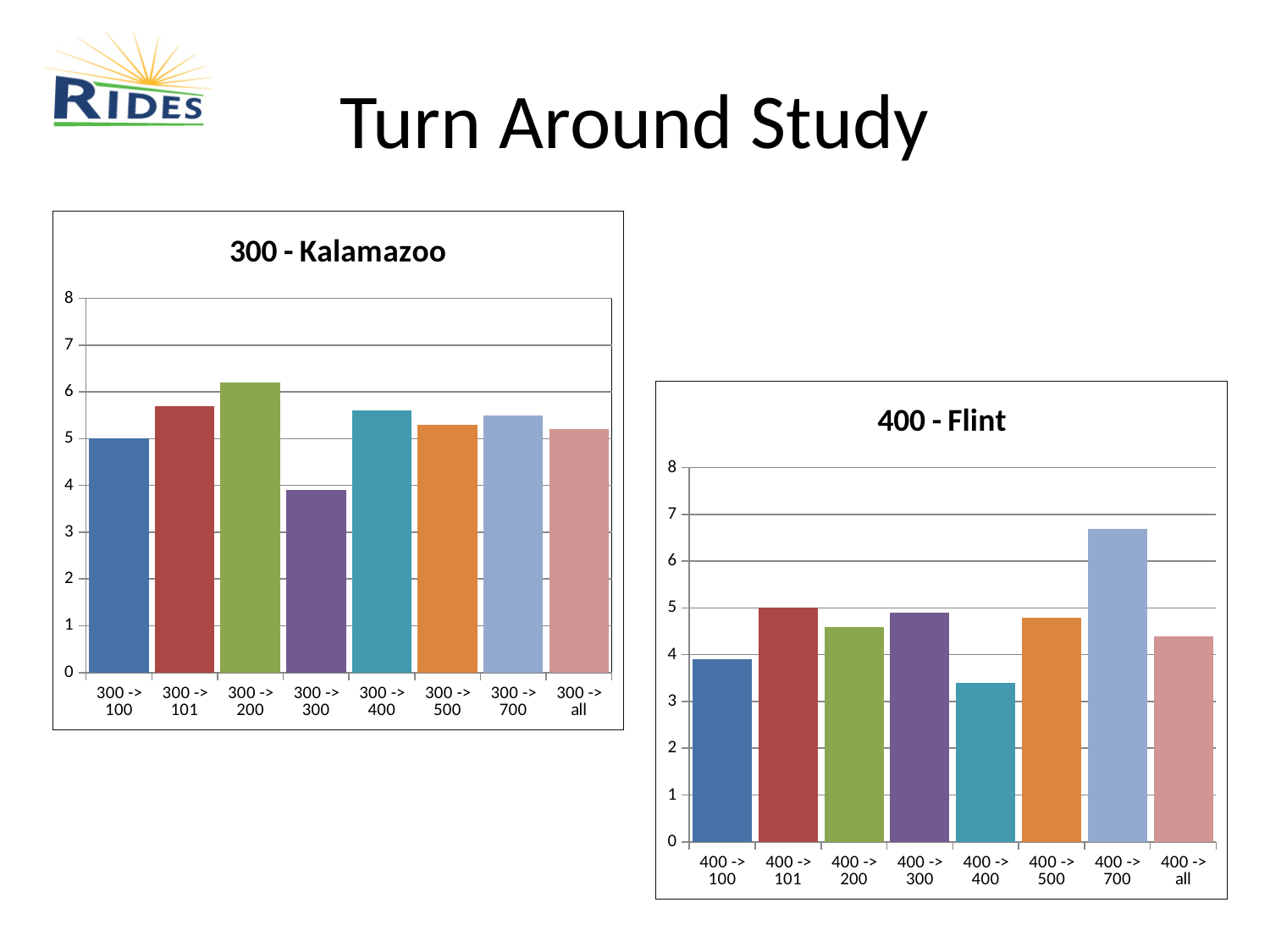
In the "400 - Flint" chart, which category has the highest value? 400 -> 700 What type of chart is the "300 - Kalamazoo" chart? bar chart In the "300 - Kalamazoo" chart, is the value for 300 -> 200 greater or less than 6? greater In the "300 - Kalamazoo" chart, which category has the lowest value? 300 -> 300 In the "400 - Flint" chart, which category has the lowest value? 400 -> 400 In the "300 - Kalamazoo" chart, is the value for 300 -> 300 greater or less than 4? less In the "400 - Flint" chart, is the value for 400 -> 700 greater or less than 6? greater What is the title of the chart on the right side of the slide? 400 - Flint How many categories are shown in the "300 - Kalamazoo" chart? 8 In the "300 - Kalamazoo" chart, which category has the highest value? 300 -> 200 In the "400 - Flint" chart, which is larger, the value for 400 -> 100 or the value for 400 -> 500? 400 -> 500 In the "300 - Kalamazoo" chart, which is larger, the value for 300 -> 200 or the value for 300 -> all? 300 -> 200